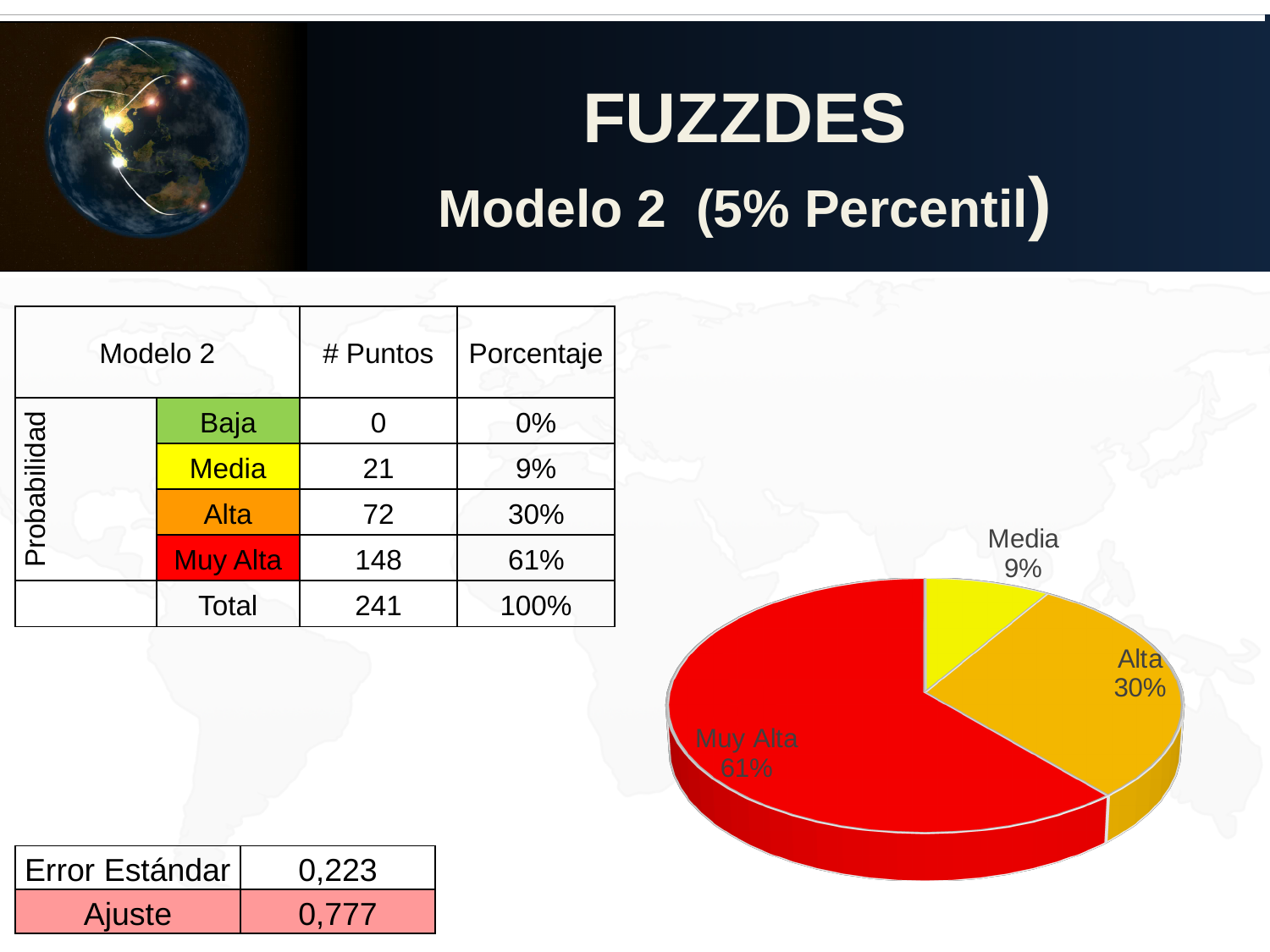
What percentage does the pie chart show for Alta? 30% What is the difference in percentage points between the Alta and Media slices? 21 What colour is the Media slice in the pie chart? yellow What is the difference in percentage points between the Muy Alta and Alta slices? 31 What percentage does the pie chart show for Muy Alta? 61% Which category has the largest slice in the pie chart? Muy Alta How many labeled slices does the pie chart have? 3 Which labeled category has the smallest slice in the pie chart? Media What percentage does the pie chart show for Media? 9% What kind of chart is shown on the slide? pie chart What colour is the Muy Alta slice in the pie chart? red Which slice is larger in the pie chart, Alta or Media? Alta